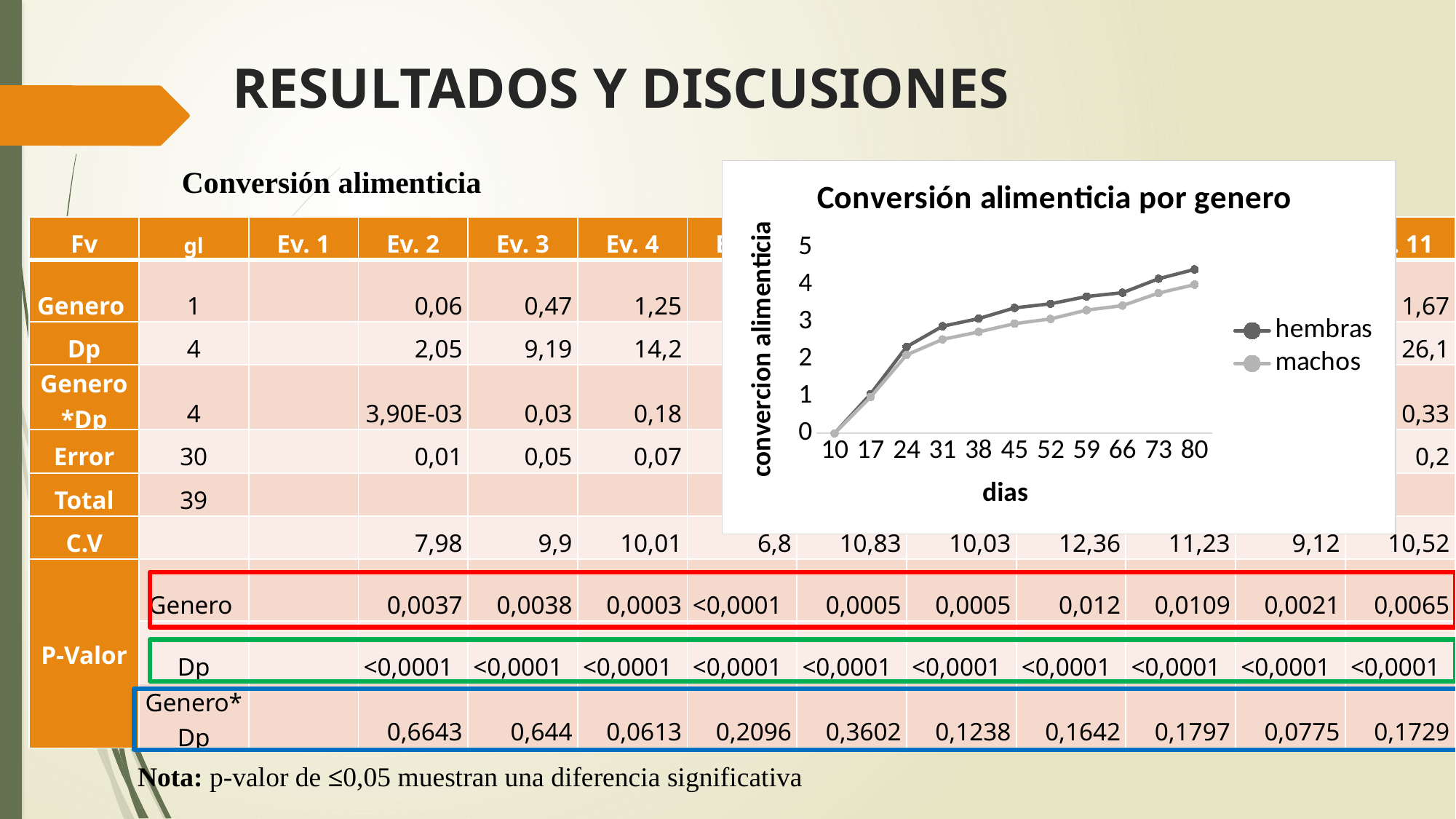
In the 'Conversión alimenticia por genero' chart, do the values for hembras rise or fall as the days increase? rise In the 'Conversión alimenticia por genero' chart, which series is higher at day 80, hembras or machos? hembras What is the label of the x axis in the 'Conversión alimenticia por genero' chart? dias In the 'Conversión alimenticia por genero' chart, is the value for hembras at day 45 greater or less than 3? greater What kind of chart is 'Conversión alimenticia por genero'? line chart How many points along the x axis (dias) does the 'Conversión alimenticia por genero' chart show for each series? 11 In the 'Conversión alimenticia por genero' chart, is the value for hembras at day 17 greater or less than 2? less In the 'Conversión alimenticia por genero' chart, is the value for hembras at day 80 greater or less than 4? greater How many series does the legend of the 'Conversión alimenticia por genero' chart list? 2 Which series are listed in the legend of the 'Conversión alimenticia por genero' chart? hembras, machos In the 'Conversión alimenticia por genero' chart, which series reaches the highest value? hembras